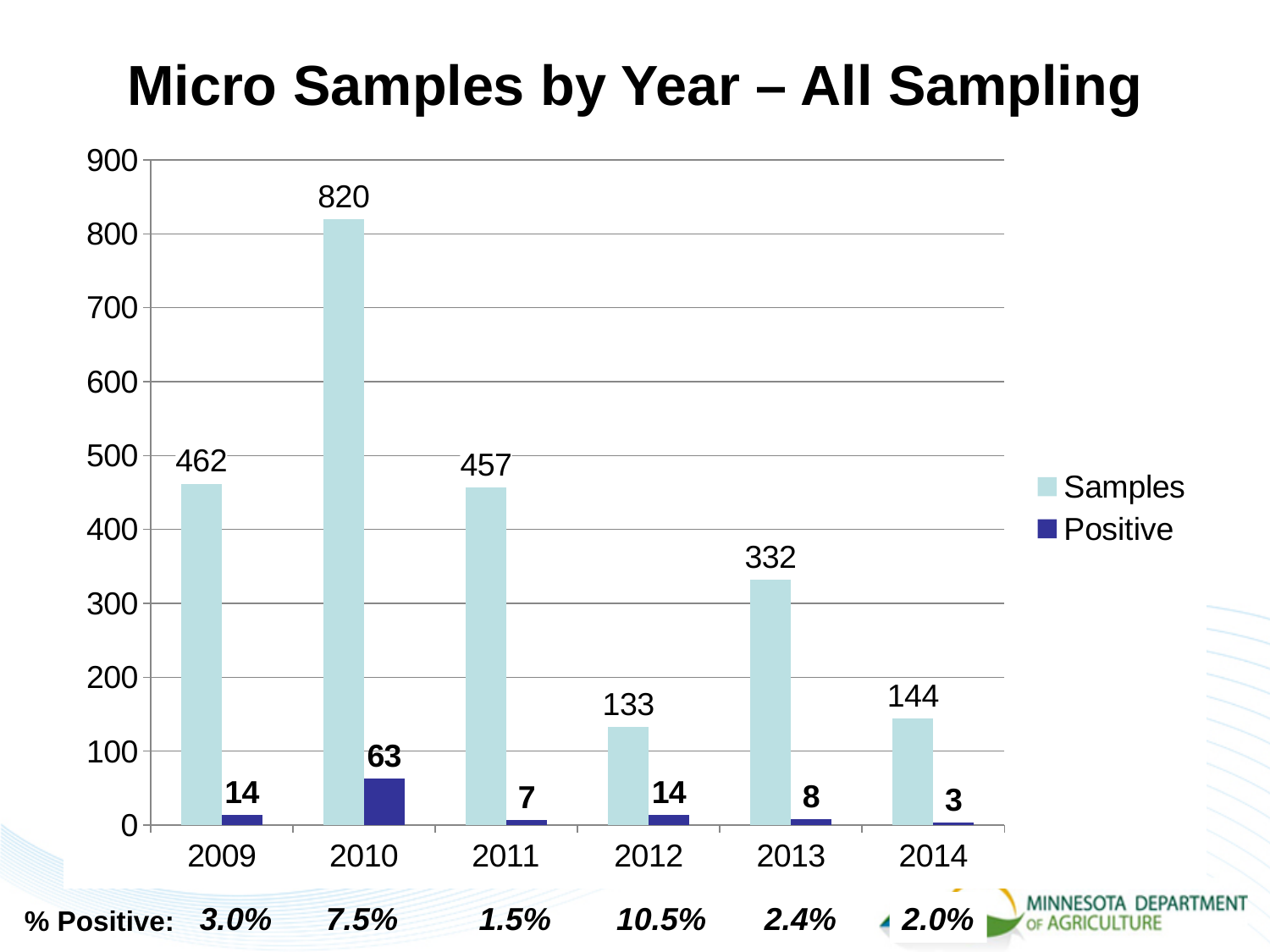
How many Samples were there in 2010? 820 What is the Positive value for 2013? 8 What is the difference between the Samples values for 2009 and 2011? 5 How many series does the legend list? 2 Which year has the highest number of Samples? 2010 Which year has the lowest Positive value? 2014 What is the title of the chart? Micro Samples by Year – All Sampling Which is larger, the Samples value for 2012 or for 2014? 2014 What is the difference between the Positive values for 2010 and 2012? 49 How many years are shown on the x axis? 6 Is the Samples value for 2013 greater or less than 300? greater What kind of chart is shown on the slide? Bar chart